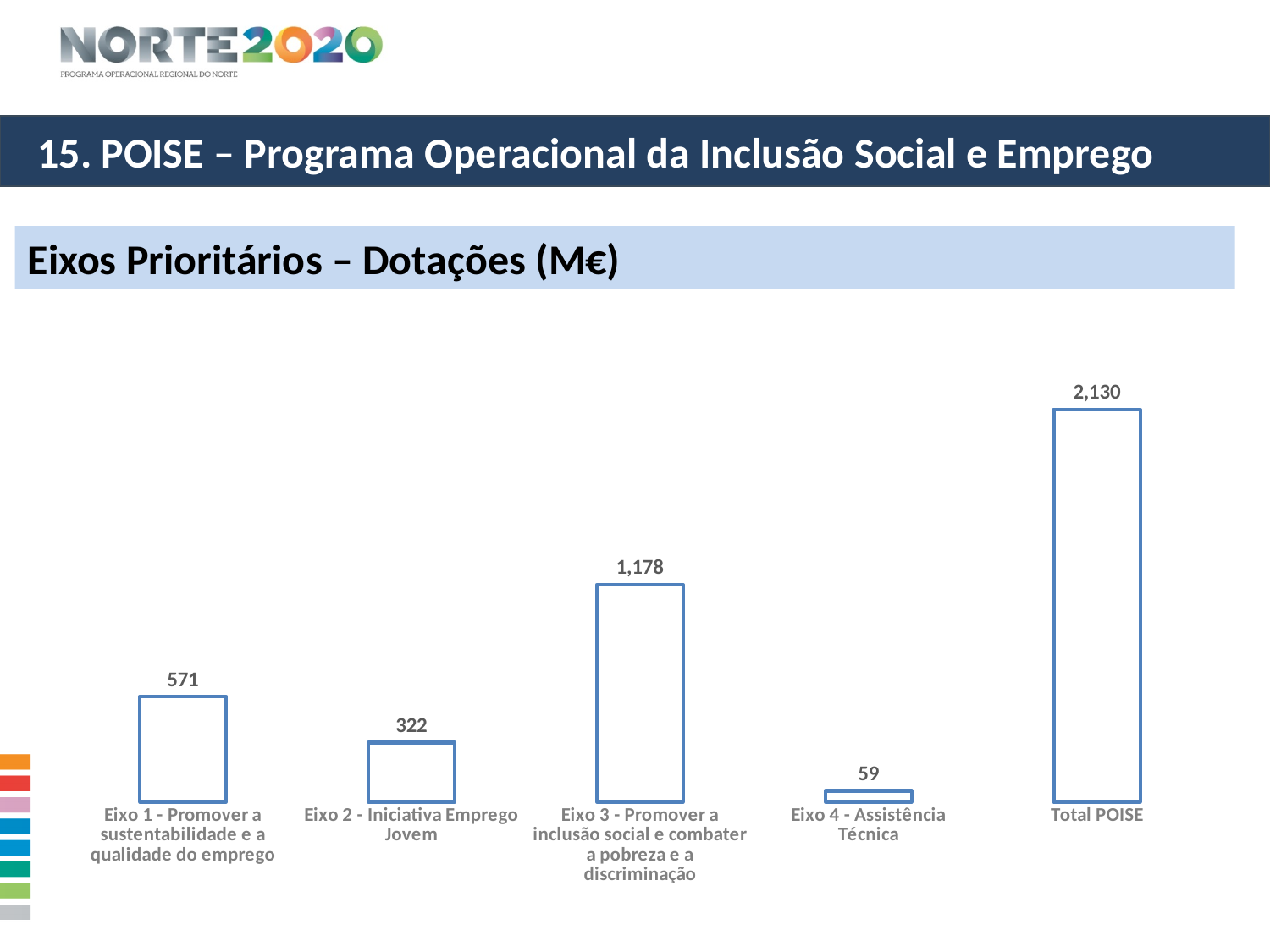
What is the value for Total POISE? 2,130 What is the value for Eixo 2 - Iniciativa Emprego Jovem? 322 What is the difference between the values for Eixo 3 and Eixo 1? 607 Which category has the lowest value? Eixo 4 - Assistência Técnica Which is larger, the value for Eixo 2 - Iniciativa Emprego Jovem or Eixo 4 - Assistência Técnica? Eixo 2 - Iniciativa Emprego Jovem What kind of chart is shown on the slide? Bar chart How many bars are shown in the chart? 5 What is the value for Eixo 4 - Assistência Técnica? 59 What is the value for Eixo 1 - Promover a sustentabilidade e a qualidade do emprego? 571 Which category has the highest value? Total POISE What is the difference between the values for Eixo 1 and Eixo 2? 249 What is the value for Eixo 3 - Promover a inclusão social e combater a pobreza e a discriminação? 1,178